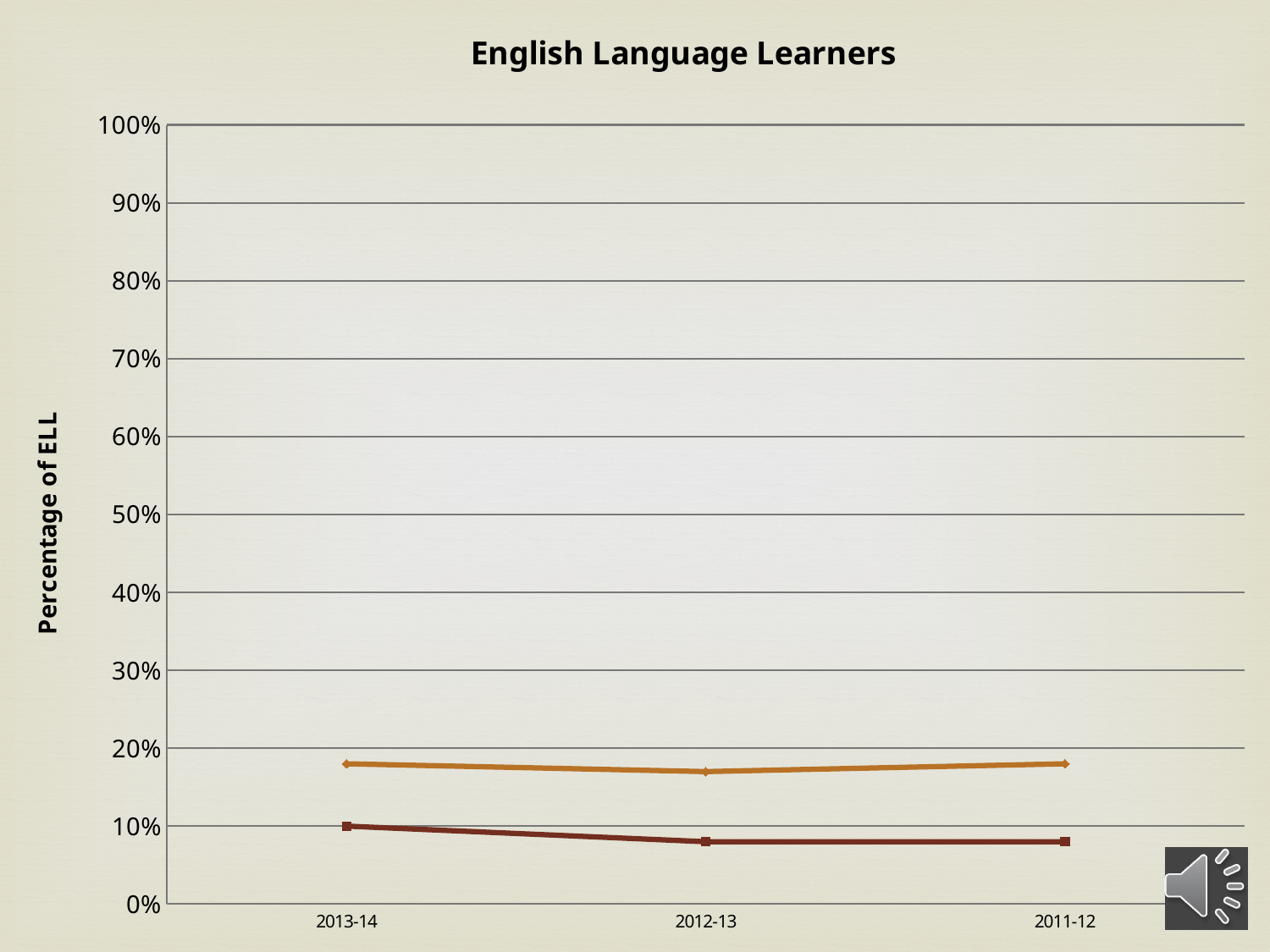
Is the value of the orange line for 2012-13 greater or less than 10%? greater Is the value of the dark brown line for 2012-13 greater or less than 10%? less Does the dark brown line rise or fall from 2013-14 to 2012-13? fall At 2013-14, which line has the higher value, the orange line or the dark brown line? the orange line What type of chart is shown on the slide? line chart Is the value of the dark brown line for 2011-12 greater or less than 20%? less How many lines are plotted on the chart? 2 What is the label on the vertical axis of the chart? Percentage of ELL At 2011-12, which line has the lower value, the orange line or the dark brown line? the dark brown line What is the title of the chart? English Language Learners How many categories are shown on the x axis of the chart? 3